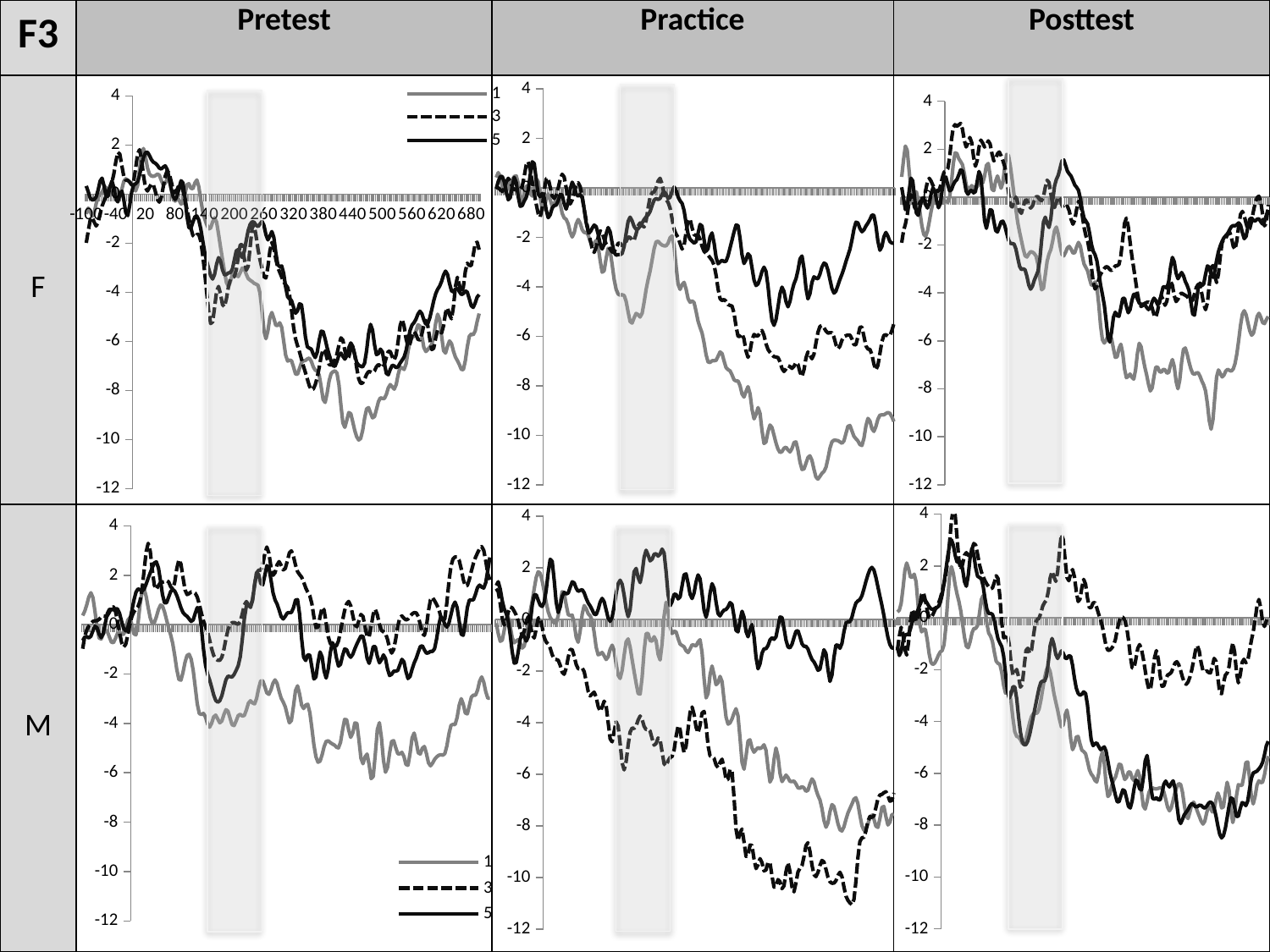
What are the legend entries shown in the F Pretest chart? 1, 3, 5 In the M Practice chart, which series reaches the lowest value? 3 How many line charts are shown on the slide? 6 What are the three column headings above the charts? Pretest, Practice, Posttest In the F Practice chart, is the lowest value reached by series 1 greater or less than -10? less In the F Posttest chart, which series reaches a lower value, series 1 or series 5? 1 In the M Practice chart, is the lowest value reached by series 3 greater or less than -10? less In the M Posttest chart, which series stays highest after 260 ms? 3 In the M Pretest chart, is the lowest value reached by series 1 greater or less than -8? greater What kind of chart is used in each panel of the slide? line chart In the F Practice chart, which series reaches the lowest value? 1 How many series does the legend in the F Pretest chart list? 3